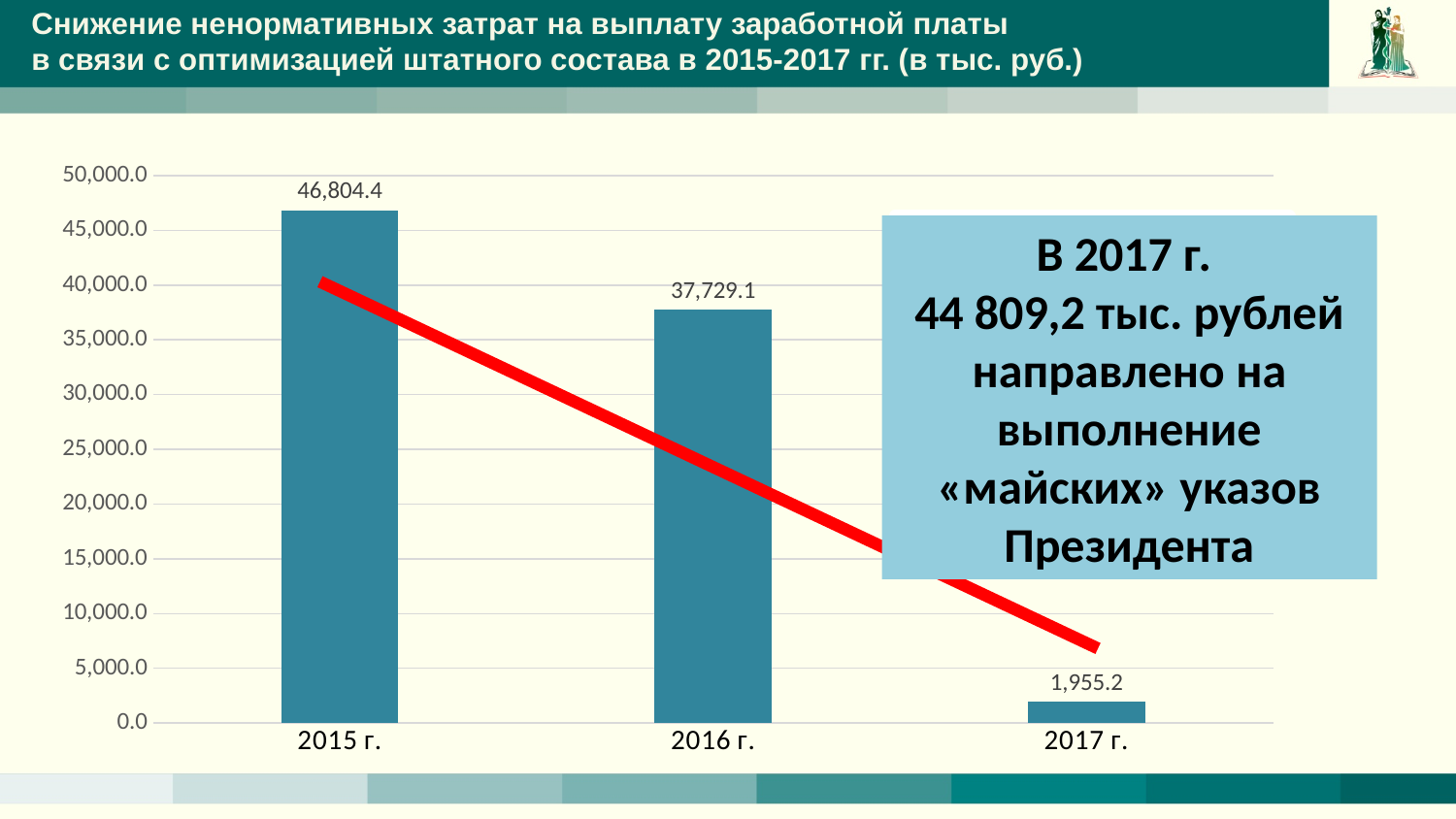
What is the difference between the values for 2015 г. and 2016 г.? 9,075.3 What is the value for 2015 г.? 46,804.4 How many years are shown on the x axis? 3 Do the values rise or fall from 2015 г. to 2017 г.? fall What is the difference between the values for 2016 г. and 2017 г.? 35,773.9 What is the value for 2016 г.? 37,729.1 What kind of chart is shown on the slide? bar chart Which year has the lowest value? 2017 г. Which year has the highest value? 2015 г. Is the value for 2016 г. greater or less than 40,000.0? less What is the value for 2017 г.? 1,955.2 Which is larger, the value for 2016 г. or the value for 2017 г.? 2016 г.